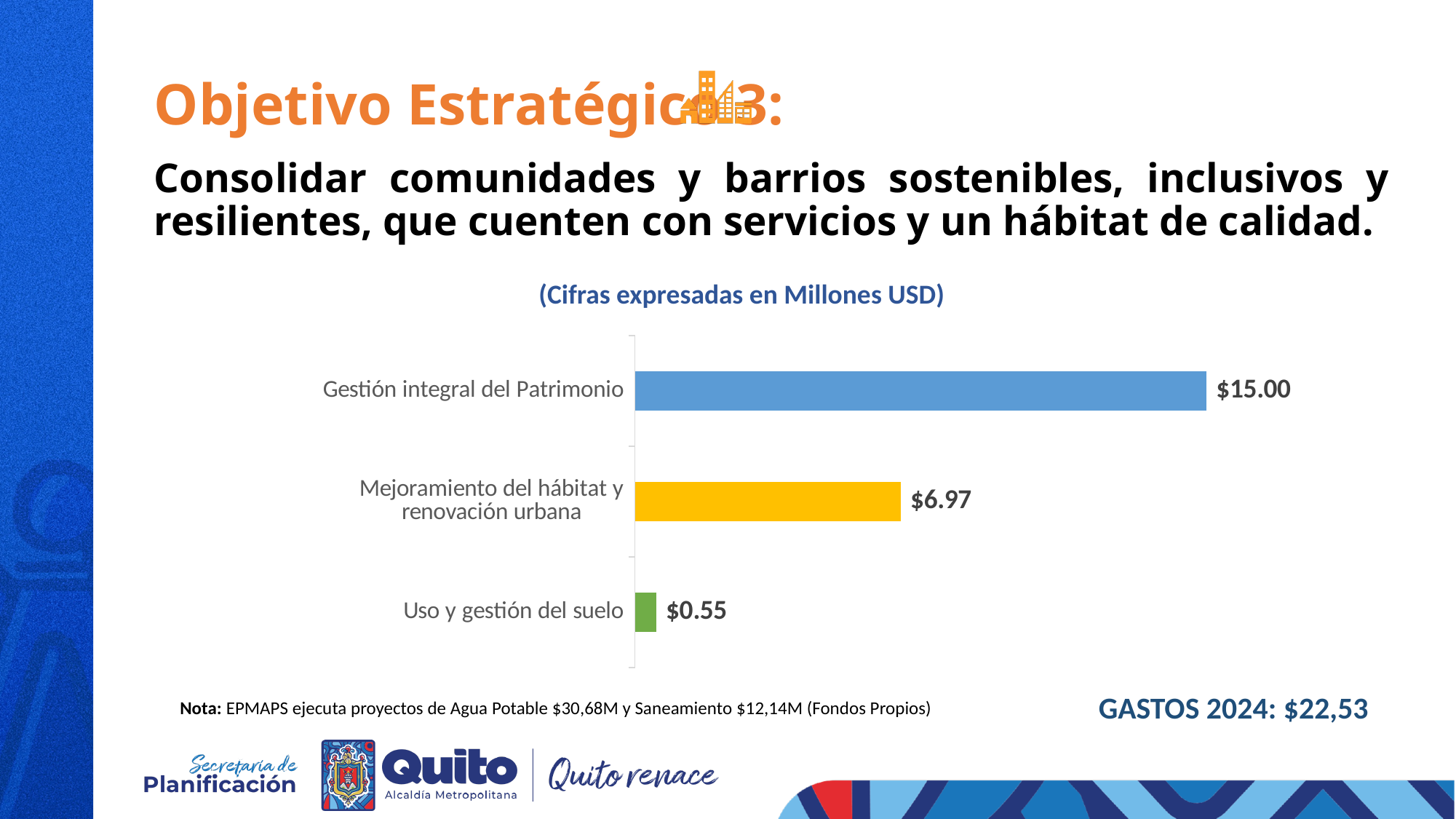
How many categories are shown in the chart? 3 What kind of chart is shown on the slide? Bar chart What is the difference between the values for Mejoramiento del hábitat y renovación urbana and Uso y gestión del suelo? $6.42 Which category has the highest value? Gestión integral del Patrimonio What is the value for Mejoramiento del hábitat y renovación urbana? $6.97 What is the difference between the values for Gestión integral del Patrimonio and Mejoramiento del hábitat y renovación urbana? $8.03 What is the total of the three values shown in the chart? $22.52 Which is larger, the value for Mejoramiento del hábitat y renovación urbana or the value for Uso y gestión del suelo? Mejoramiento del hábitat y renovación urbana In what units are the figures in the chart expressed, according to the subtitle? Millones USD What is the value for Gestión integral del Patrimonio? $15.00 What is the value for Uso y gestión del suelo? $0.55 Which category has the lowest value? Uso y gestión del suelo